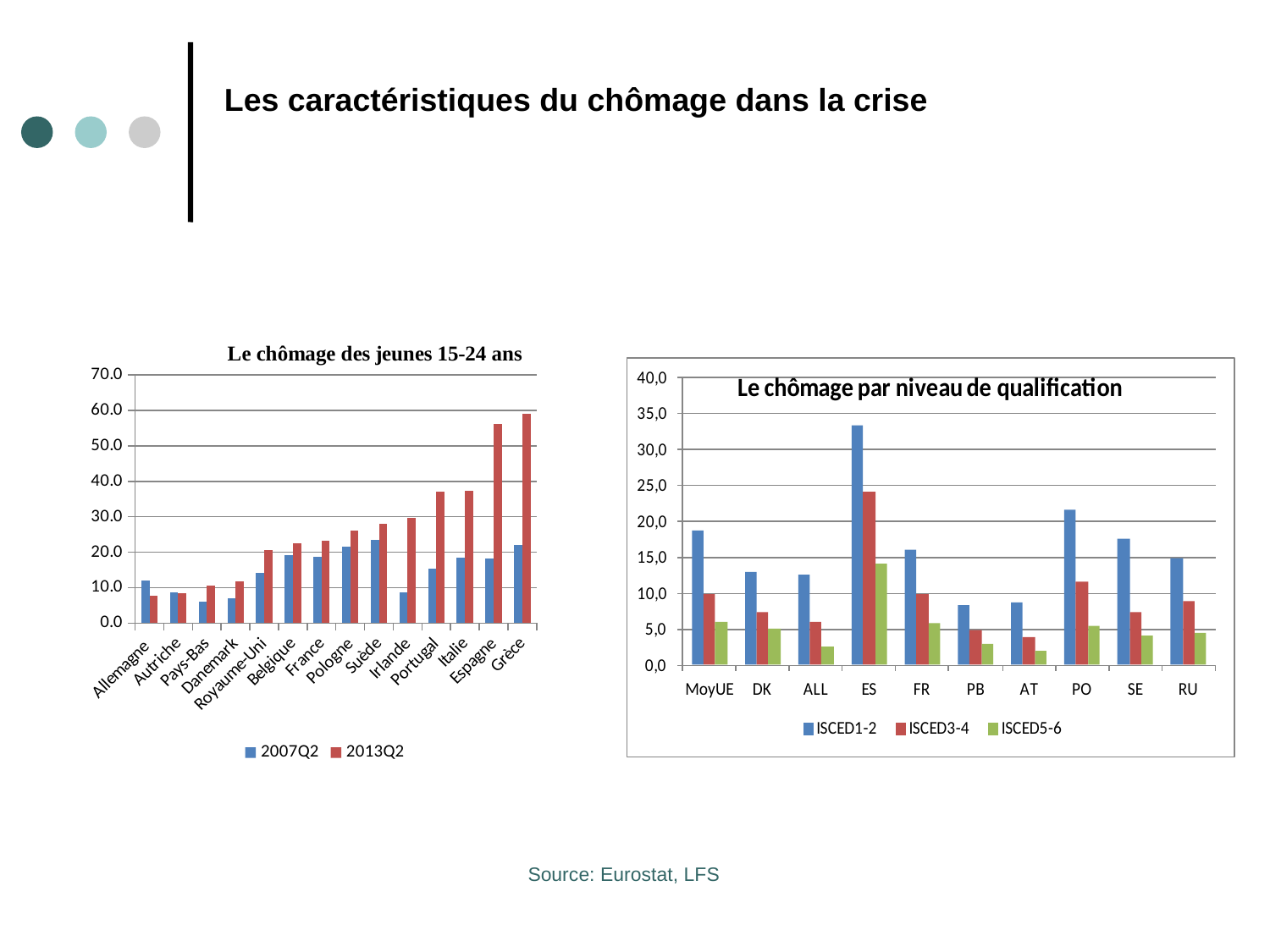
On the chart titled "Le chômage des jeunes 15-24 ans", is the 2013Q2 value for Portugal greater or less than 30? greater On the chart titled "Le chômage des jeunes 15-24 ans", which is larger for Allemagne: the 2007Q2 value or the 2013Q2 value? 2007Q2 On the chart titled "Le chômage par niveau de qualification", which series has the larger value for MoyUE: ISCED1-2 or ISCED3-4? ISCED1-2 On the chart titled "Le chômage par niveau de qualification", how many series does the legend list? 3 On the chart titled "Le chômage des jeunes 15-24 ans", how many series does the legend list? 2 On the chart titled "Le chômage par niveau de qualification", is the ISCED1-2 value for PO greater or less than 20? greater On the chart titled "Le chômage des jeunes 15-24 ans", is the 2013Q2 value for Allemagne greater or less than 10? less On the chart titled "Le chômage par niveau de qualification", which category has the highest ISCED1-2 value? ES On the chart titled "Le chômage des jeunes 15-24 ans", how many countries are shown on the x axis? 14 On the chart titled "Le chômage des jeunes 15-24 ans", which country has the highest value for 2013Q2? Grèce